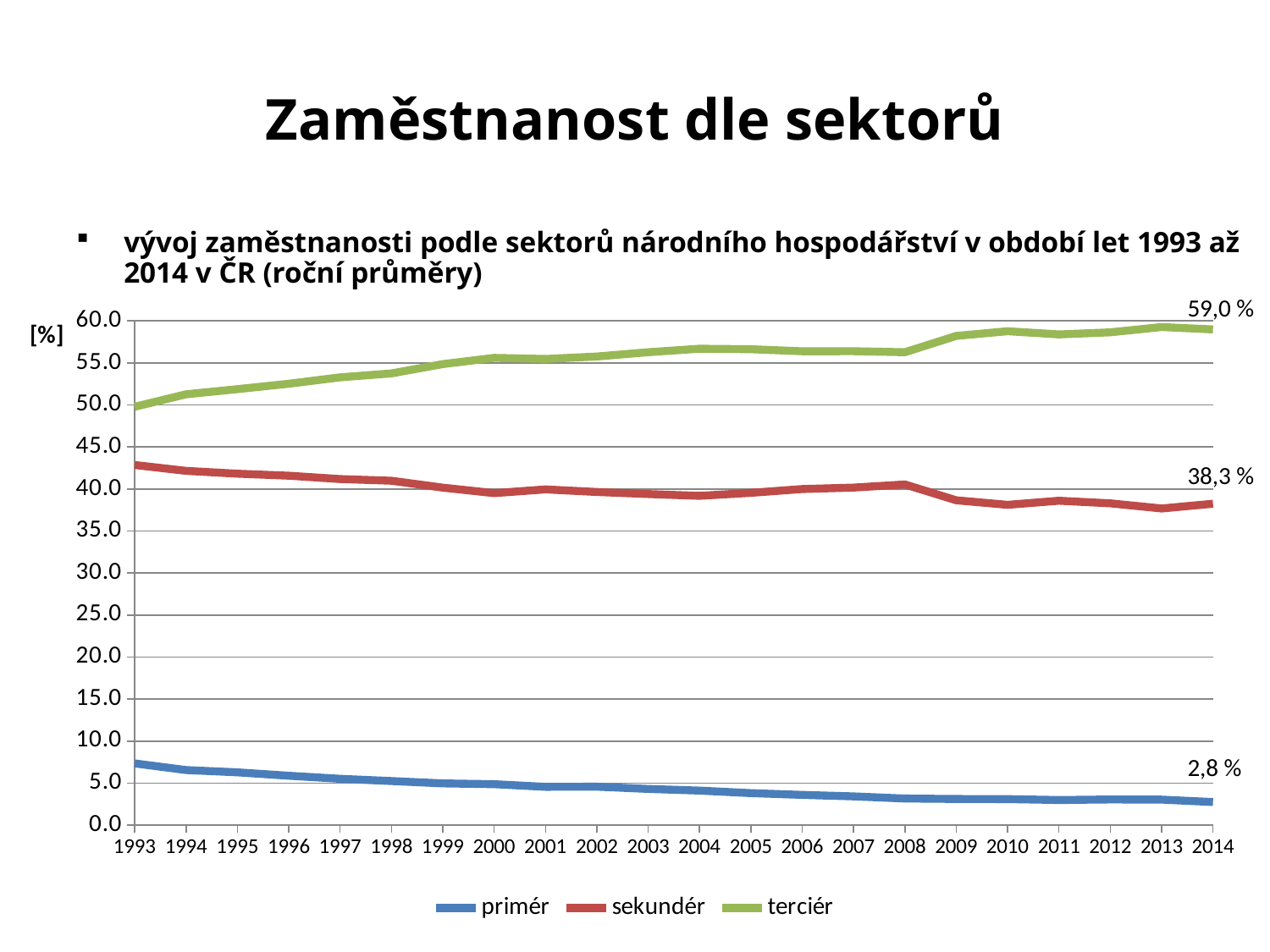
Which series has the lowest value in 2014? primér What is the value for primér in 2014? 2,8 % How many series does the legend list? 3 What is the value for sekundér in 2014? 38,3 % Which series are listed in the legend? primér, sekundér, terciér Does the terciér series rise or fall from 1993 to 2014? rise What is the value for terciér in 2014? 59,0 % Which series has the highest value in 2014? terciér Is the value for sekundér in 1993 greater or less than 40.0? greater What kind of chart is shown on the slide? line chart What is the difference between the terciér and sekundér values in 2014? 20,7 % Does the primér series rise or fall from 1993 to 2014? fall